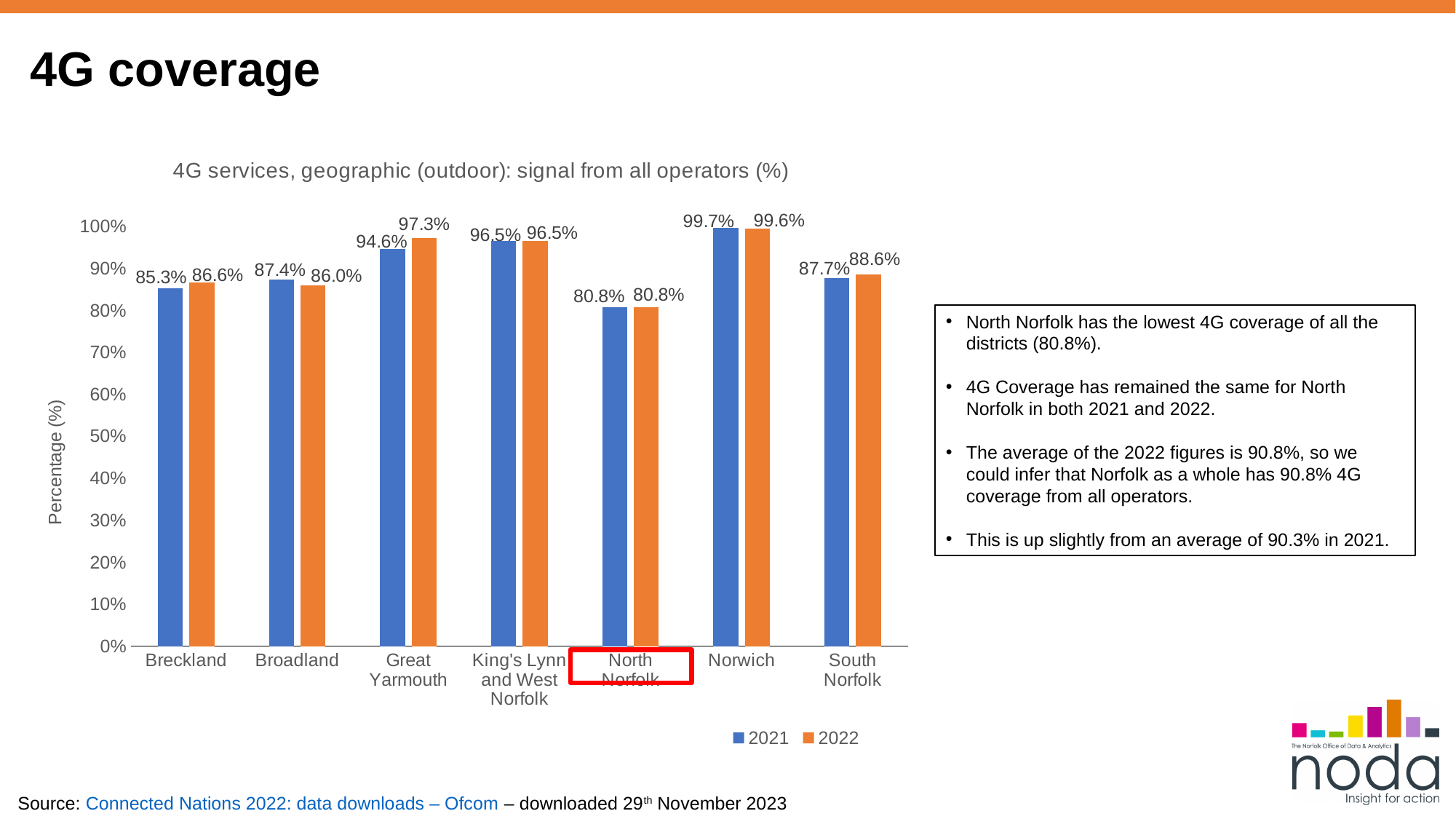
How many series does the legend list? 2 Which is larger for Broadland, the 2021 value or the 2022 value? 2021 What is the 2021 value for Breckland? 85.3% How many districts are shown on the x axis? 7 Which district has the lowest 2021 value? North Norfolk What is the difference between the 2022 and 2021 values for Breckland? 1.3% What is the 2022 value for Great Yarmouth? 97.3% Which district has the highest 2022 value? Norwich What kind of chart is shown? bar chart Is the 2022 value for North Norfolk greater or less than 90%? less What is the difference between the 2021 values for Norwich and North Norfolk? 18.9% What is the 2022 value for South Norfolk? 88.6%